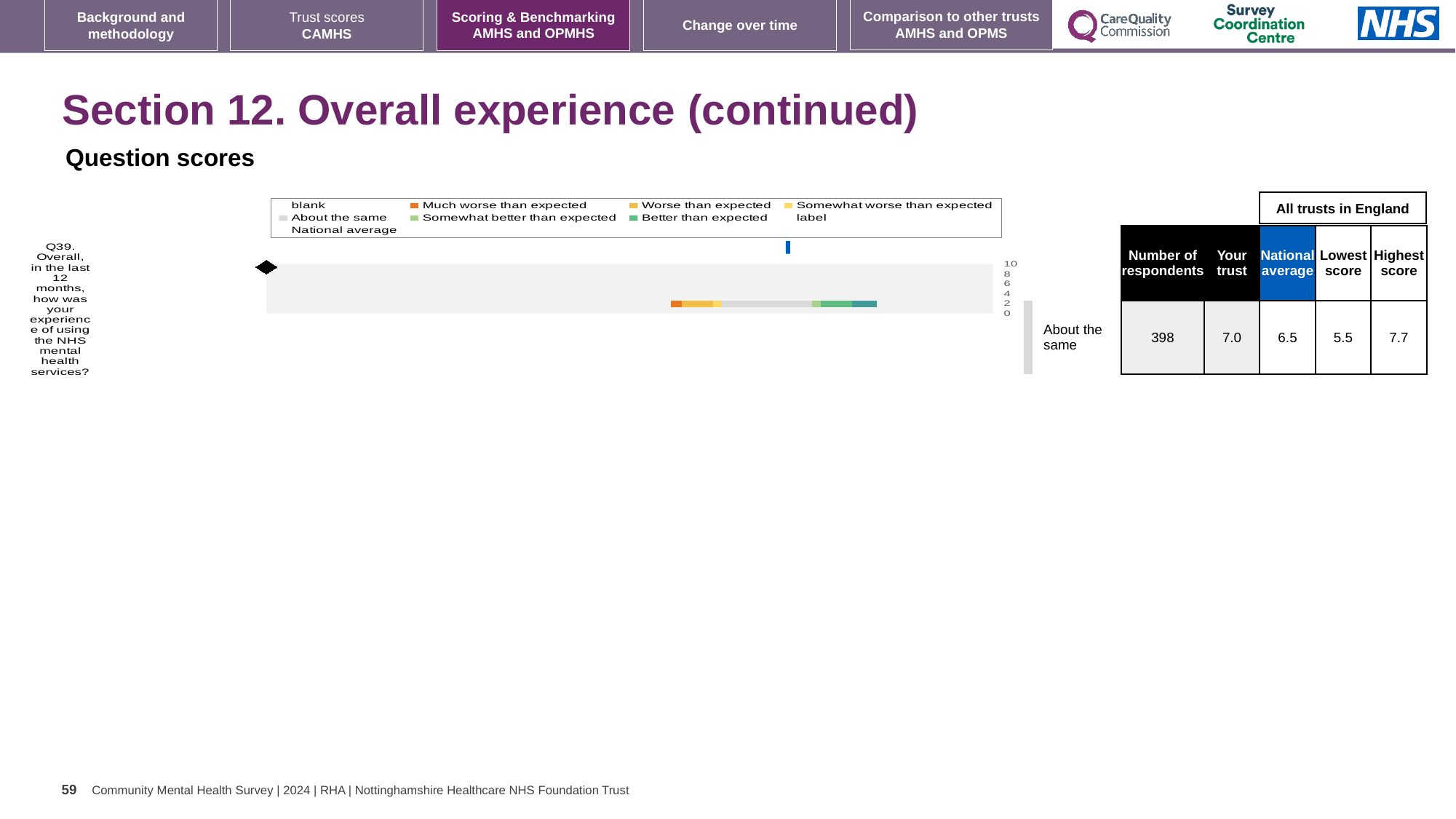
According to the label next to the chart, how does the trust's score for Q39 compare with expectations? About the same How many questions (categories) are plotted in the chart? 1 In the table beside the chart, what is the lowest score among all trusts in England for Q39? 5.5 In the table beside the chart, what is the highest score among all trusts in England for Q39? 7.7 In the table beside the chart, what is the number of respondents for Q39? 398 In the table beside the chart, what is the 'Your trust' score for Q39? 7.0 Which question number is plotted in the chart? Q39 In the table beside the chart, what is the national average score for Q39? 6.5 What is the highest value shown on the chart's axis? 10 Is the 'Your trust' score for Q39 larger or smaller than the national average? larger What is the difference between the highest score and the lowest score for Q39 in the table? 2.2 What kind of chart is shown for Q39 on the slide? bar chart